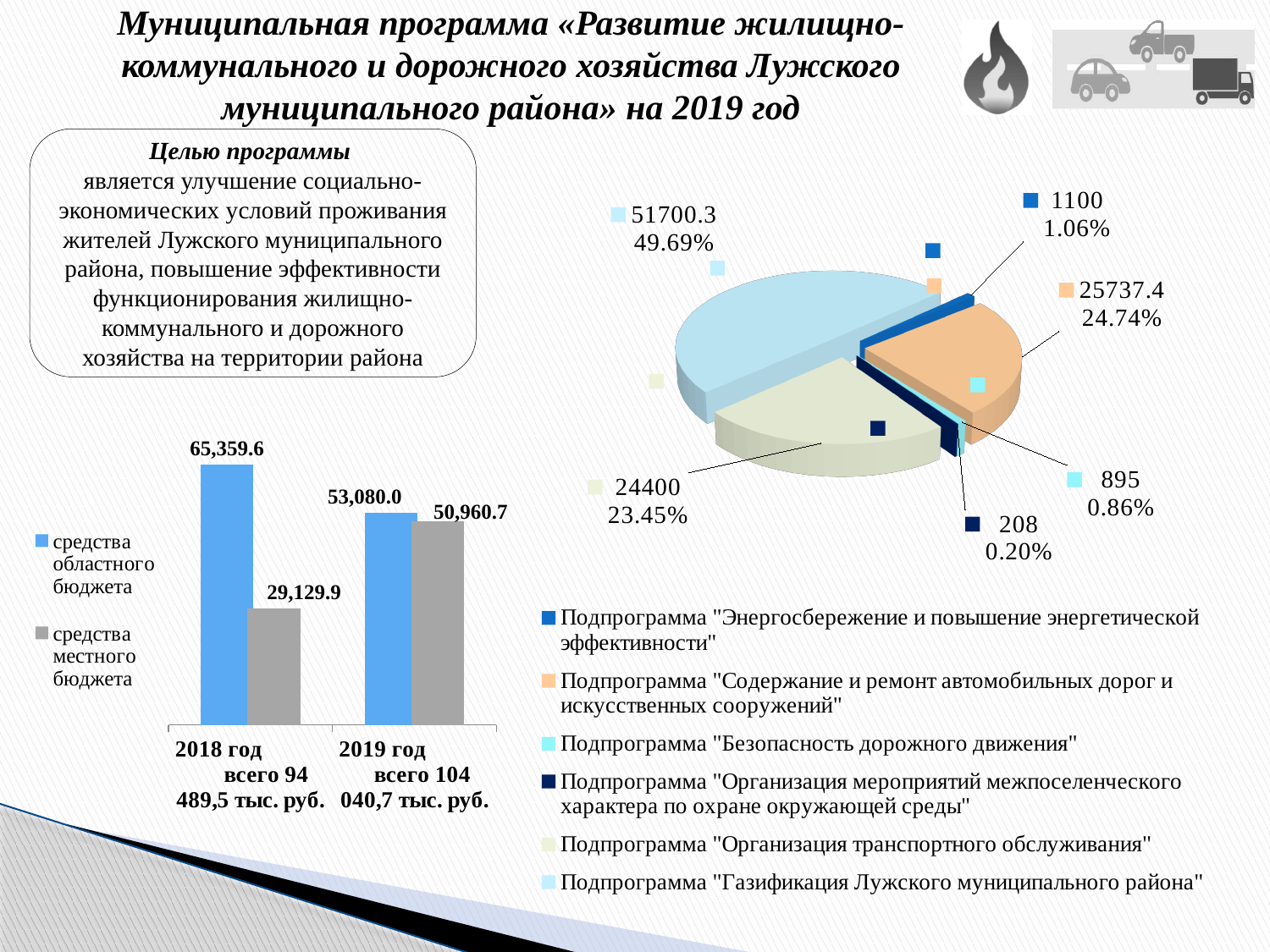
What kind of chart is the chart on the left of the slide? bar chart In the pie chart on the right, what is the share of Подпрограмма "Безопасность дорожного движения"? 0.86% In the bar chart on the left, what is the value of средства местного бюджета for 2019 год? 50,960.7 In the pie chart on the right, which subprogram has the smallest slice? Подпрограмма "Организация мероприятий межпоселенческого характера по охране окружающей среды" In the bar chart on the left, how many series does the legend list? 2 In the pie chart on the right, how many slices are there? 6 In the bar chart on the left, what is the value of средства областного бюджета for 2018 год? 65,359.6 In the pie chart on the right, what is the value for Подпрограмма "Содержание и ремонт автомобильных дорог и искусственных сооружений"? 25737.4 In the bar chart on the left, what is the difference between средства областного бюджета and средства местного бюджета in 2018 год? 36,229.7 In the pie chart on the right, which subprogram has the largest slice? Подпрограмма "Газификация Лужского муниципального района" In the bar chart on the left, which is larger in 2019 год: средства областного бюджета or средства местного бюджета? средства областного бюджета In the pie chart on the right, what share does Подпрограмма "Газификация Лужского муниципального района" have? 49.69%